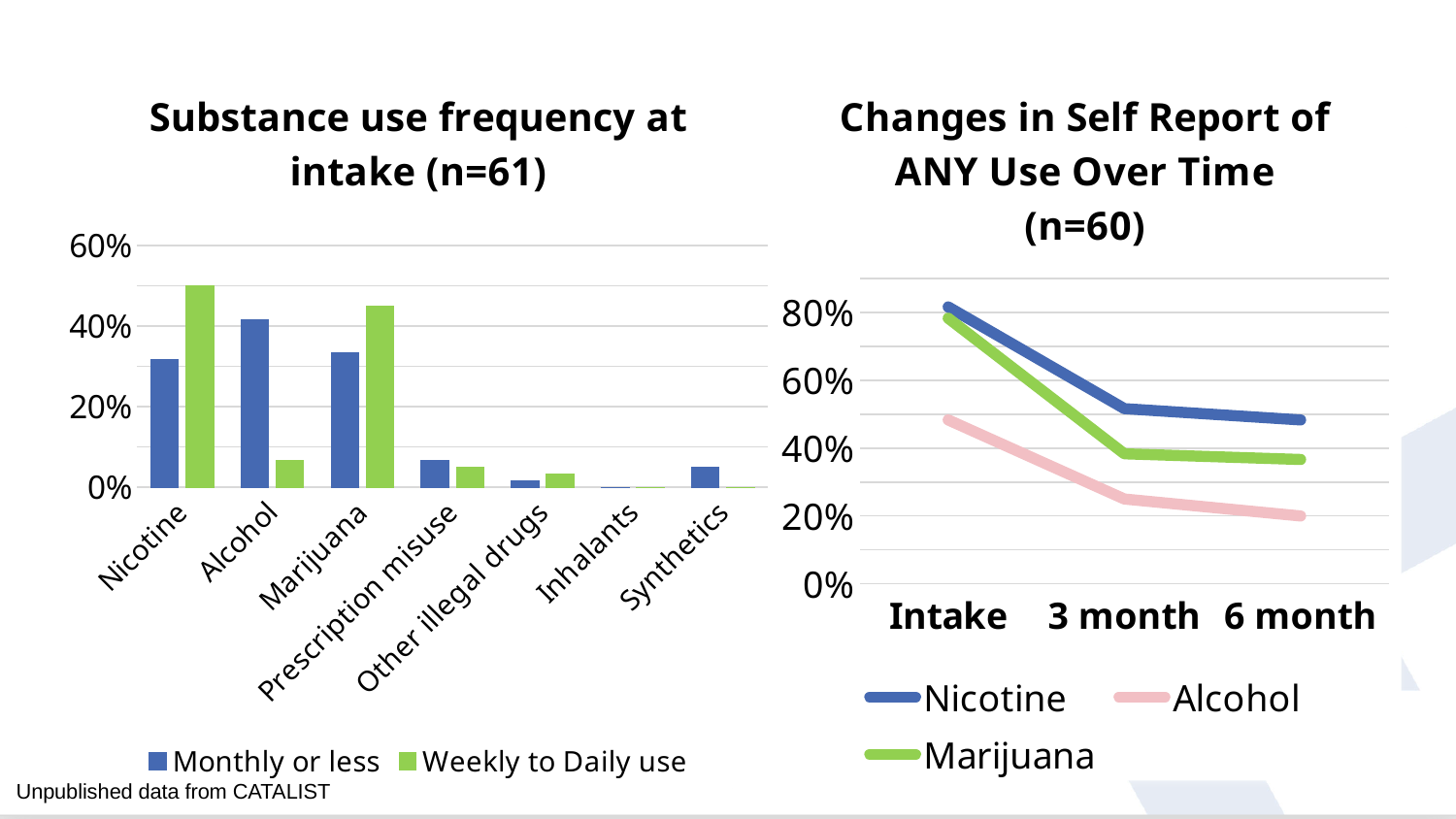
In the 'Changes in Self Report of ANY Use Over Time (n=60)' chart, which substance has the lowest value at Intake? Alcohol In the 'Substance use frequency at intake (n=61)' chart, which substance has the highest 'Monthly or less' bar? Alcohol What kind of chart is 'Substance use frequency at intake (n=61)'? Bar chart In the 'Changes in Self Report of ANY Use Over Time (n=60)' chart, do the values for Nicotine rise or fall from Intake to 6 month? Fall In the 'Substance use frequency at intake (n=61)' chart, which is larger for Marijuana: 'Monthly or less' or 'Weekly to Daily use'? Weekly to Daily use How many series does the legend of the 'Substance use frequency at intake (n=61)' chart list? 2 In the 'Substance use frequency at intake (n=61)' chart, is the 'Weekly to Daily use' value for Alcohol greater or less than 20%? less In the 'Changes in Self Report of ANY Use Over Time (n=60)' chart, is the value for Alcohol at 6 month greater or less than 40%? less What kind of chart is 'Changes in Self Report of ANY Use Over Time (n=60)'? Line chart In the 'Substance use frequency at intake (n=61)' chart, which substance has the highest 'Weekly to Daily use' bar? Nicotine In the 'Substance use frequency at intake (n=61)' chart, is the 'Weekly to Daily use' value for Nicotine greater or less than 40%? greater How many substance categories are shown on the x axis of the 'Substance use frequency at intake (n=61)' chart? 7